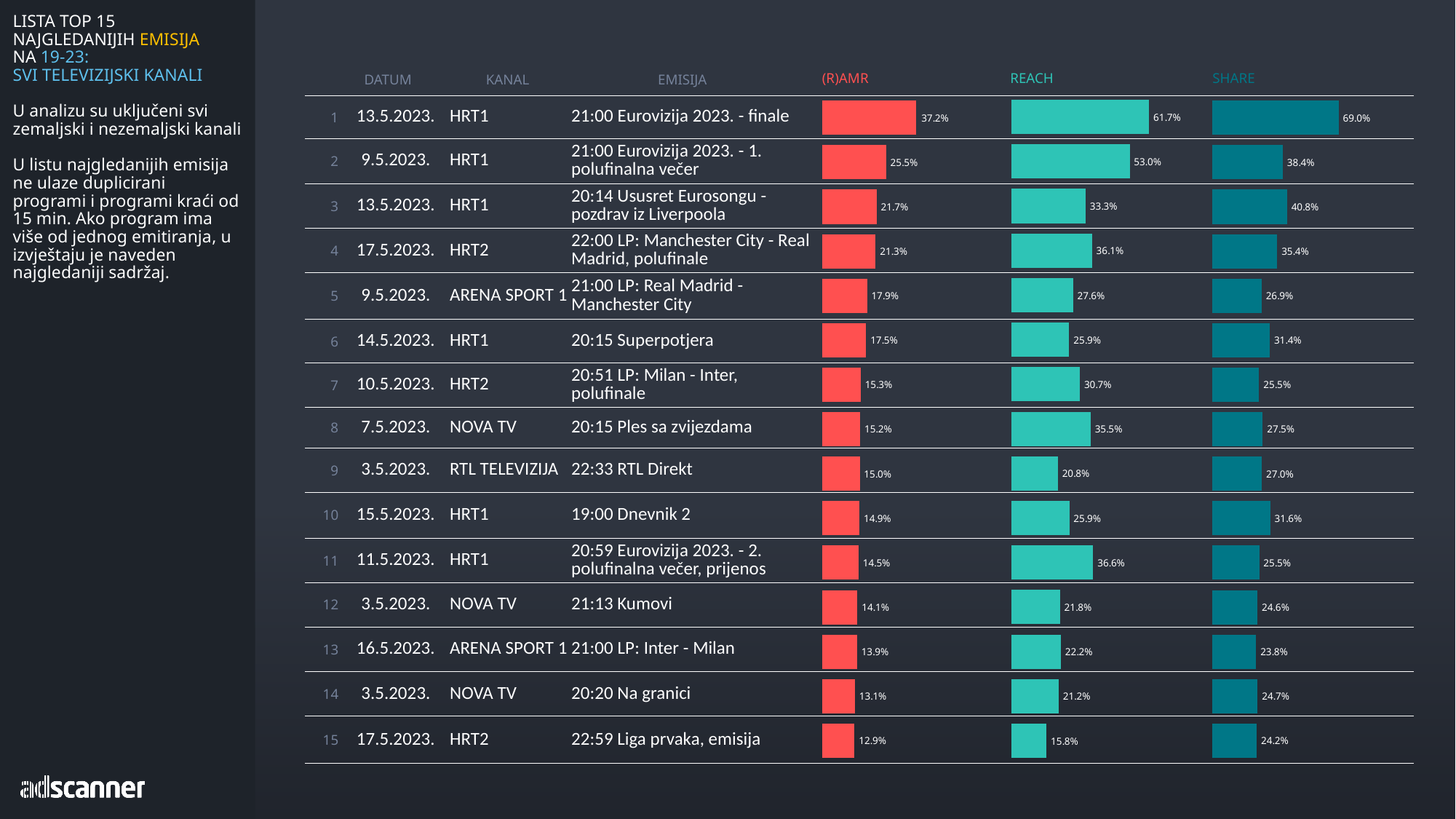
What colour are the bars in the (R)AMR chart? Red In the (R)AMR chart, what is the value for "21:00 Eurovizija 2023. - finale"? 37.2% In the REACH chart, what is the value for "20:15 Ples sa zvijezdama"? 35.5% In the SHARE chart, what is the difference between "21:00 Eurovizija 2023. - finale" and "21:00 Eurovizija 2023. - 1. polufinalna večer"? 30.6% What kind of chart is used to show the REACH values? Bar chart In the REACH chart, which programme has the lowest value? 22:59 Liga prvaka, emisija How many programmes are listed in the (R)AMR chart? 15 In the (R)AMR chart, what is the difference between "21:00 Eurovizija 2023. - finale" and "21:00 Eurovizija 2023. - 1. polufinalna večer"? 11.7% In the SHARE chart, which programme has the lowest value? 21:00 LP: Inter - Milan In the REACH chart, which programme has the highest value? 21:00 Eurovizija 2023. - finale In the SHARE chart, what is the value for "20:14 Ususret Eurosongu - pozdrav iz Liverpoola"? 40.8% In the REACH chart, which is larger: "20:51 LP: Milan - Inter, polufinale" or "20:15 Ples sa zvijezdama"? 20:15 Ples sa zvijezdama